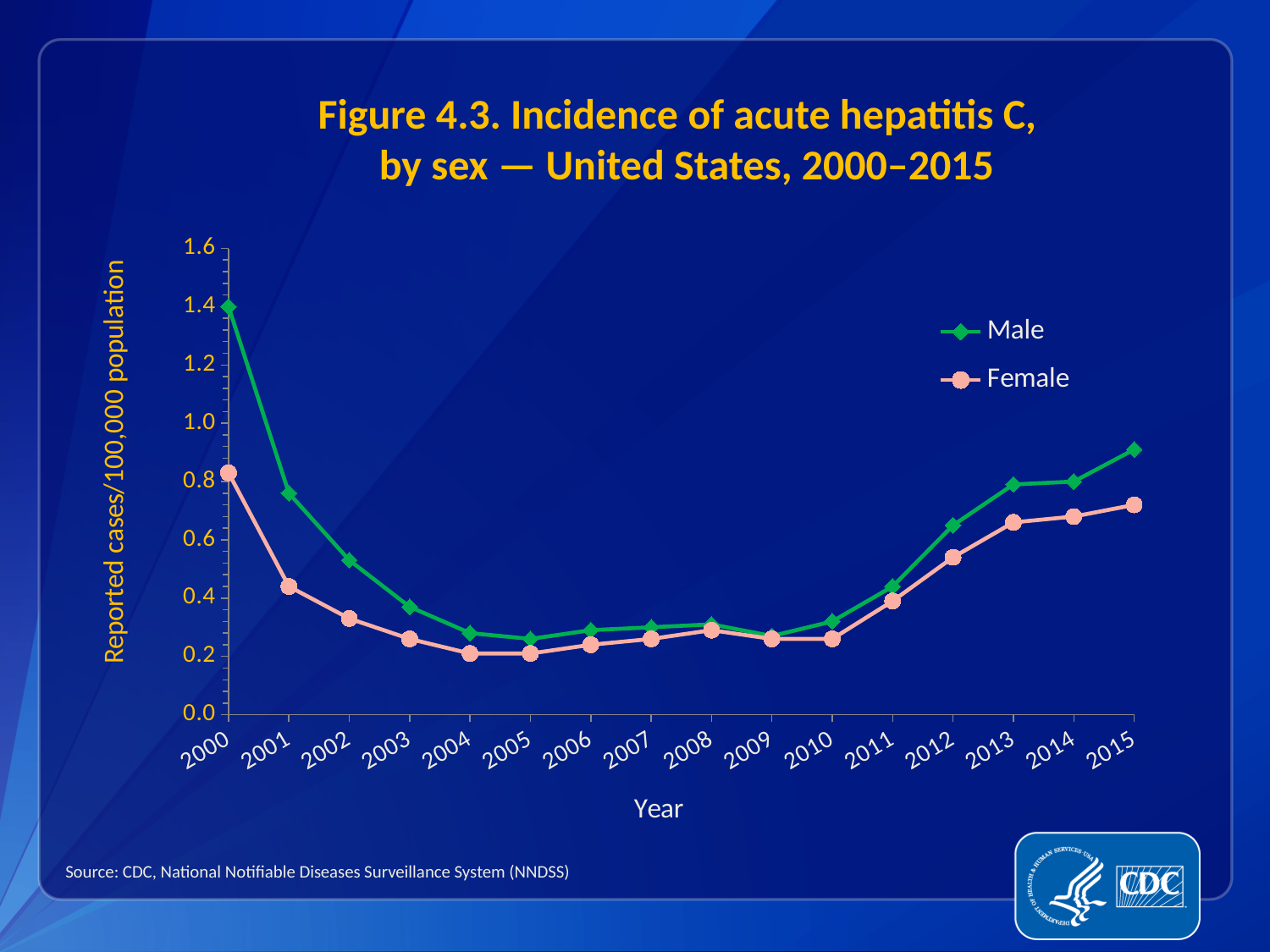
How many years are plotted along the x axis? 16 Which series has the larger value in 2013, Male or Female? Male Do the Male values rise or fall from 2000 to 2004? Fall Do the Female values rise or fall from 2010 to 2015? Rise How many series does the legend list? 2 What kind of chart is shown on the slide? Line chart In which year is the Female incidence rate highest? 2000 What is the label on the y axis? Reported cases/100,000 population In which year is the Male incidence rate highest? 2000 Is the Male value for 2004 greater or less than 0.4? less Is the Male value for 2000 greater or less than 1.2? greater Is the Female value for 2015 greater or less than 0.8? less